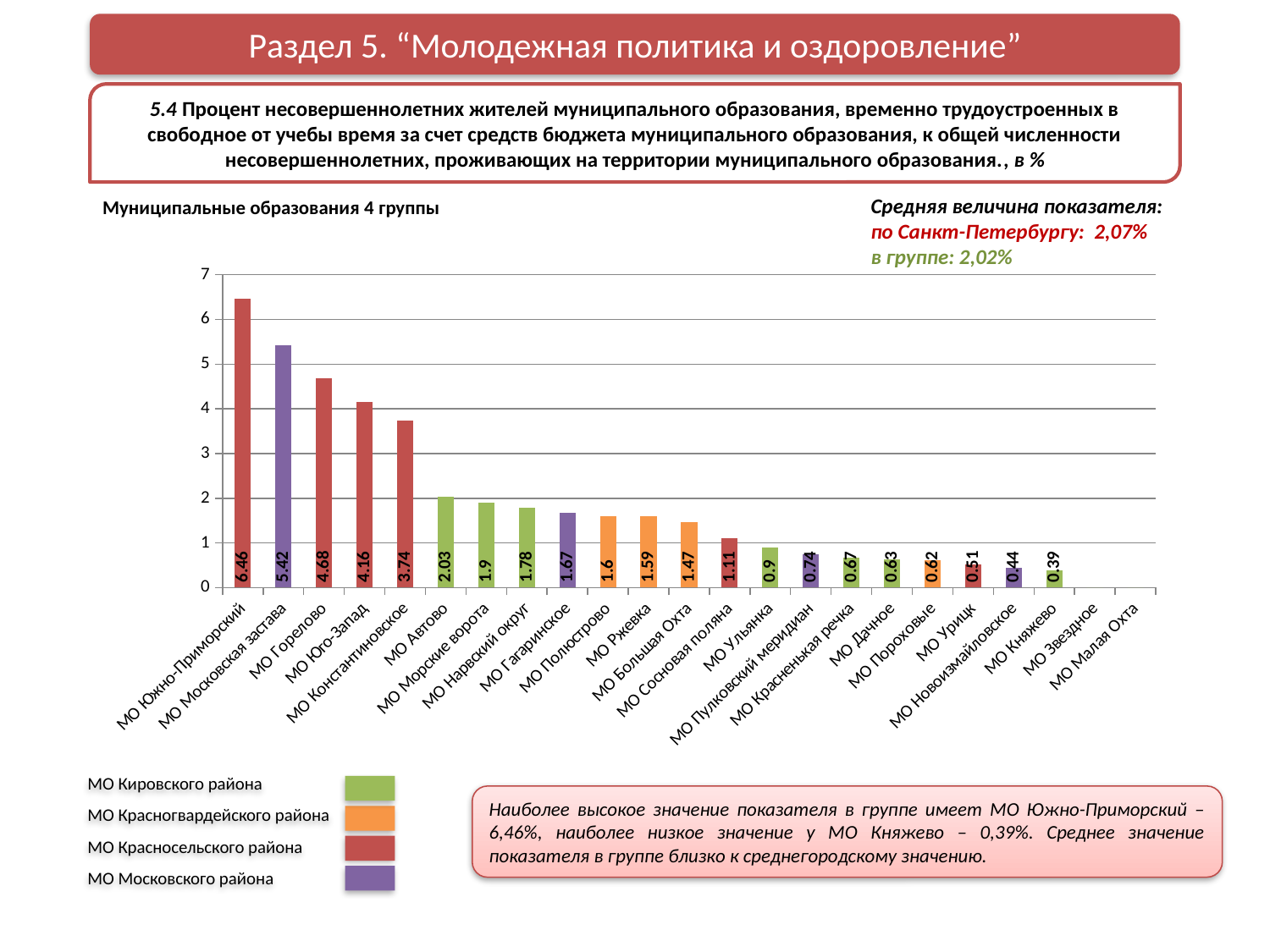
Do the values rise or fall from left to right along the x axis? fall What kind of chart is shown on the slide? bar chart How many municipalities are listed along the x axis of the chart? 23 Among the bars with data labels, which municipality has the lowest value? МО Княжево Which municipality has the highest value in the chart? МО Южно-Приморский What colour are the bars for МО Московского района according to the legend? purple What is the difference between the values for МО Южно-Приморский and МО Московская застава? 1.04 What is the value for МО Княжево? 0.39 What is the value for МО Южно-Приморский? 6.46 What is the value for МО Автово? 2.03 Which is larger, the value for МО Горелово or for МО Юго-Запад? МО Горелово Is the value for МО Константиновское greater or less than 3? greater